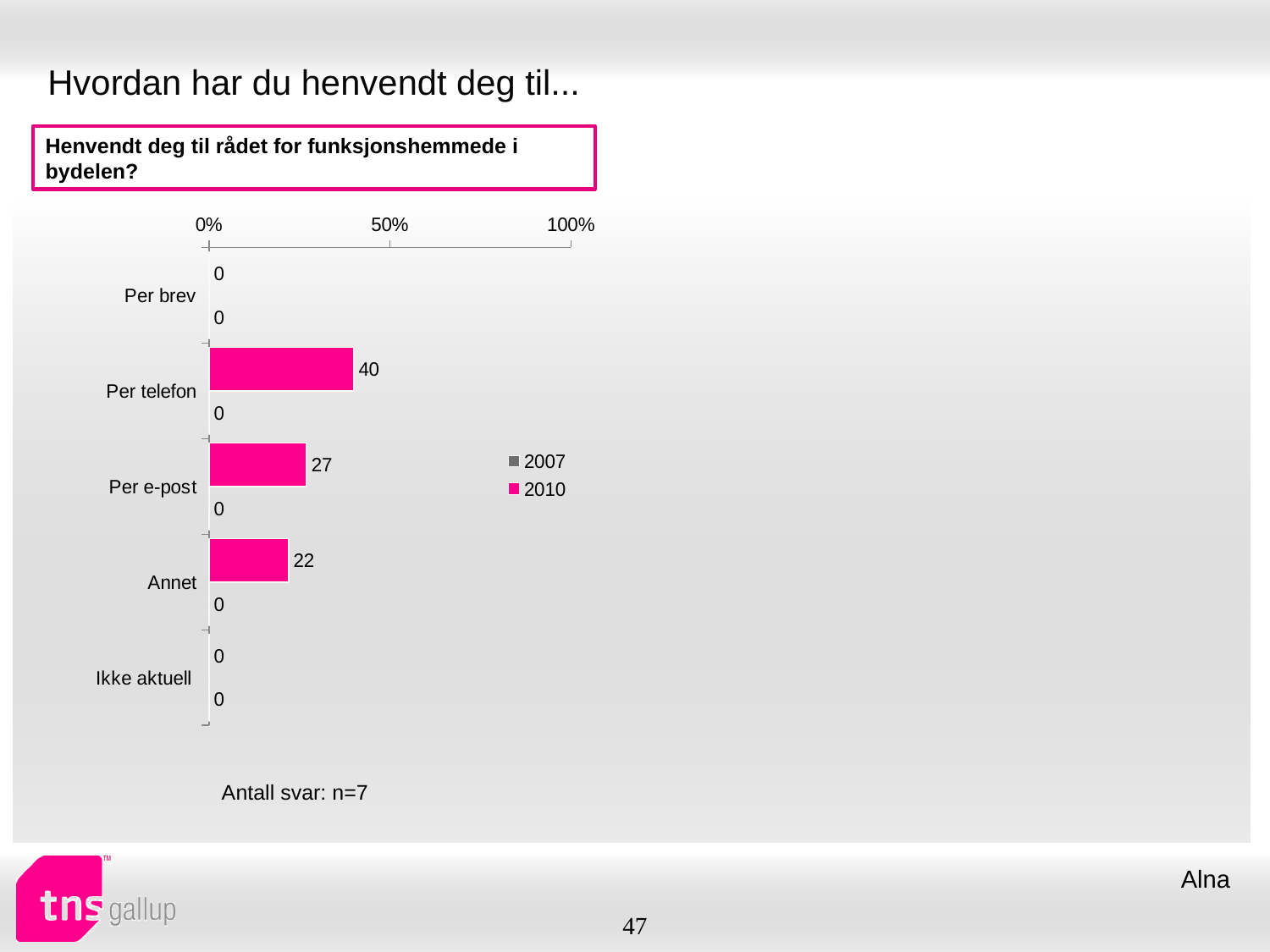
What is the 2010 value for Annet? 22 How many categories are shown on the chart? 5 Which category has the highest 2010 value? Per telefon What type of chart is shown on the slide? bar chart What is the 2010 value for Per telefon? 40 What is the number of responses (n) stated below the chart? n=7 What is the difference between the 2010 values for Per telefon and Per e-post? 13 Which is larger for 2010: Per e-post or Annet? Per e-post How many series does the legend list? 2 What is the 2010 value for Per e-post? 27 What is the 2007 value for Per telefon? 0 Is the 2010 value for Per telefon greater or less than 50%? less